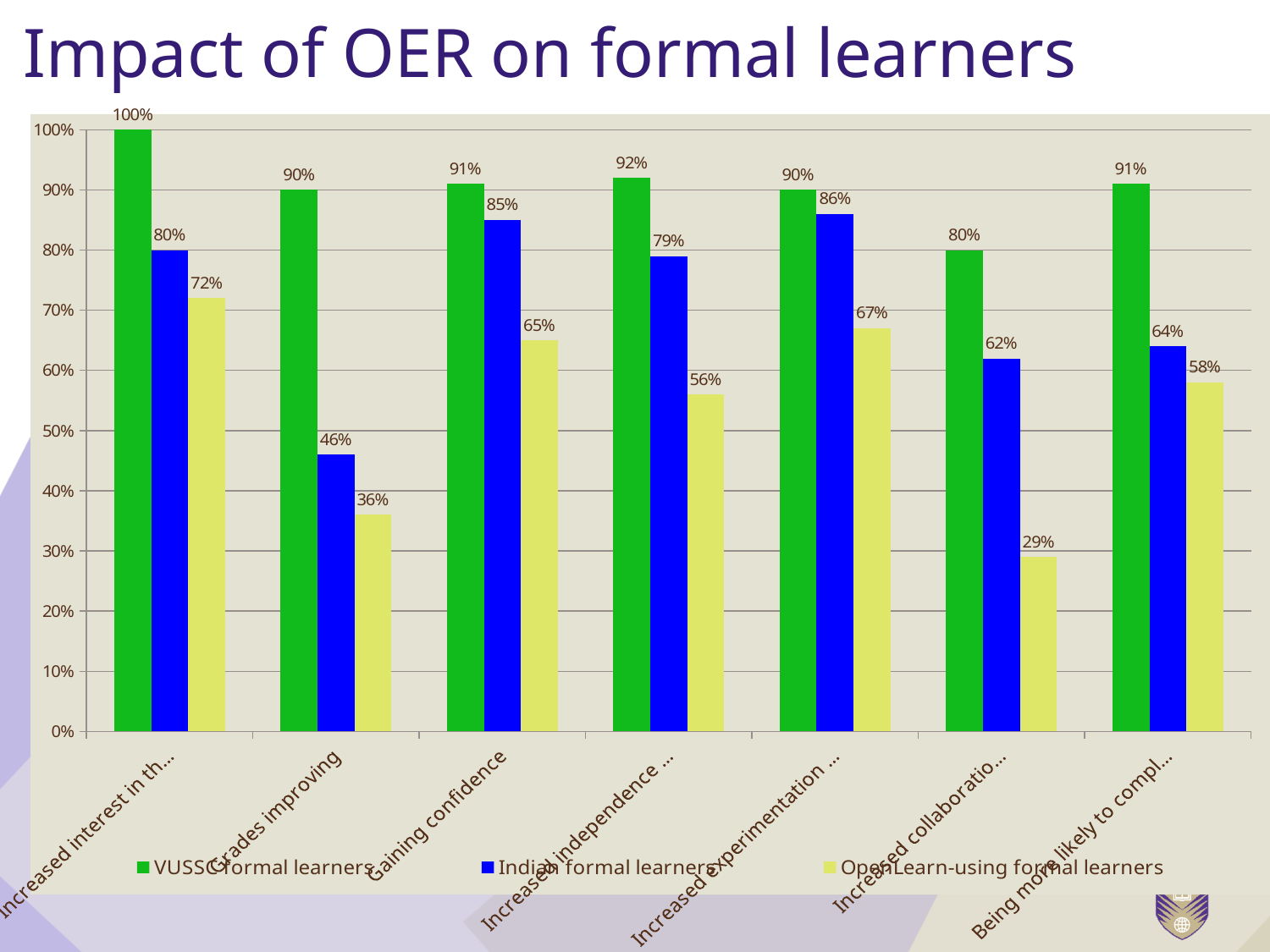
What is the difference between the VUSSC formal learners and Indian formal learners values for Grades improving? 44% What is the value for VUSSC formal learners for Grades improving? 90% For Gaining confidence, which is larger: the Indian formal learners value or the OpenLearn-using formal learners value? Indian formal learners Which category has the highest value for VUSSC formal learners? Increased interest in th... What is the value for Indian formal learners for Grades improving? 46% How many categories are shown on the x axis? 7 How many series does the legend list? 3 What is the difference between the OpenLearn-using formal learners values for Gaining confidence and Grades improving? 29% What kind of chart is shown on the slide? Bar chart What is the value for OpenLearn-using formal learners for Gaining confidence? 65% Which series is shown in green? VUSSC formal learners Which category has the lowest value for OpenLearn-using formal learners? Increased collaboratio...